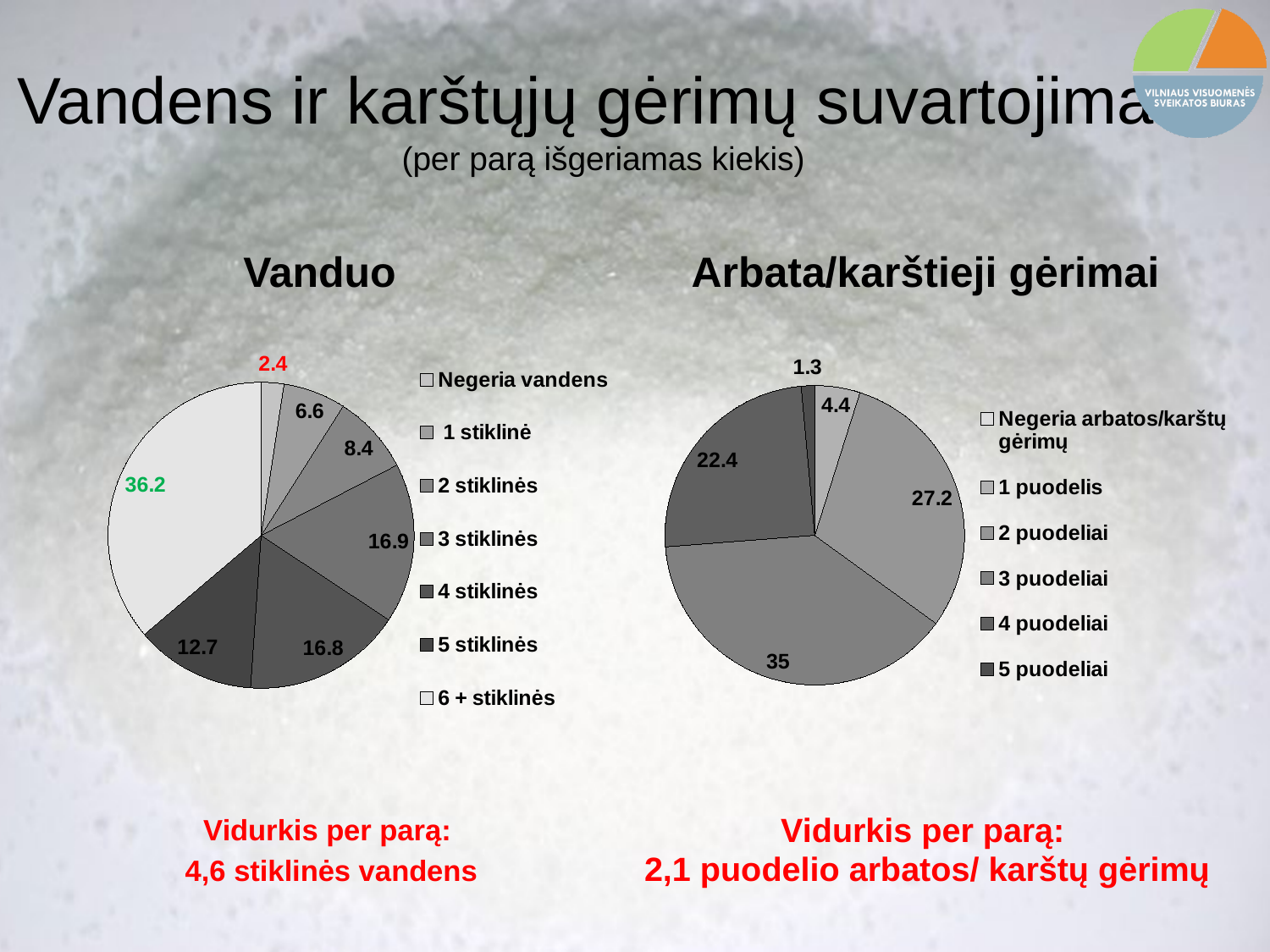
How many entries does the legend of the "Arbata/karštieji gėrimai" chart list? 6 In the "Vanduo" chart, what is the value for "3 stiklinės"? 16.9 In the "Arbata/karštieji gėrimai" chart, which is larger, the value for "2 puodeliai" or the value for "4 puodeliai"? 2 puodeliai In the "Arbata/karštieji gėrimai" chart, what is the largest value shown? 35 In the "Vanduo" chart, which category has the largest slice? 6 + stiklinės What type of chart is used for "Vanduo"? pie chart In the "Vanduo" chart, what is the value for "Negeria vandens"? 2.4 In the "Vanduo" chart, what is the value for "6 + stiklinės"? 36.2 In the "Vanduo" chart, what is the difference between the values for "2 stiklinės" and "1 stiklinė"? 1.8 In the "Vanduo" chart, which category has the smallest slice? Negeria vandens In the "Vanduo" chart, what is the value for "5 stiklinės"? 12.7 How many entries does the legend of the "Vanduo" chart list? 7